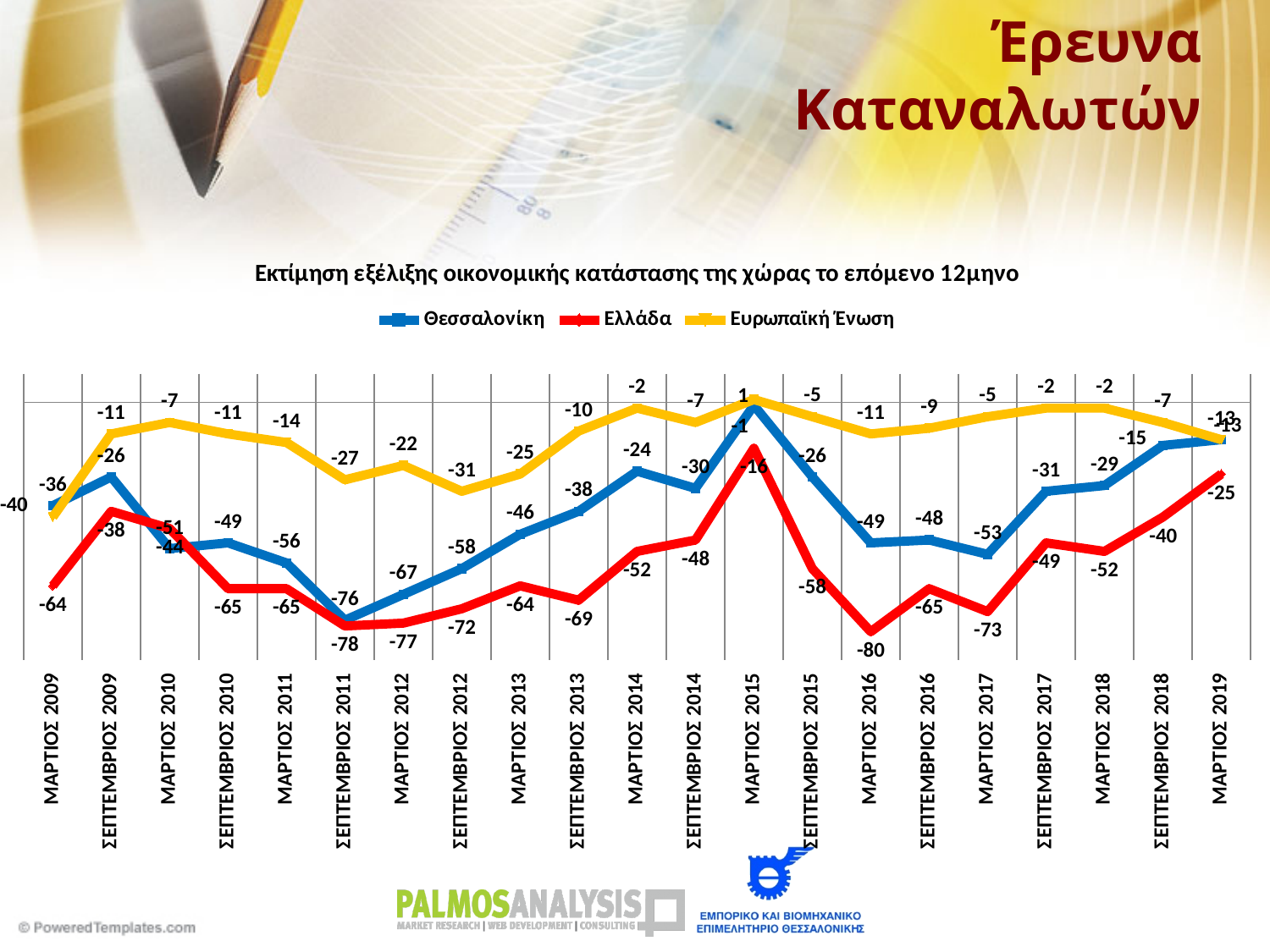
In which period does the Ελλάδα series reach its lowest value? ΜΑΡΤΙΟΣ 2016 In which period does the Θεσσαλονίκη series reach its lowest value? ΣΕΠΤΕΜΒΡΙΟΣ 2011 How many time points are plotted along the x axis? 21 What kind of chart is shown on the slide? line chart Does the Θεσσαλονίκη series rise or fall from ΣΕΠΤΕΜΒΡΙΟΣ 2011 to ΜΑΡΤΙΟΣ 2014? rise What colour is the line for Ελλάδα? red In ΜΑΡΤΙΟΣ 2012, which is higher: Θεσσαλονίκη or Ελλάδα? Θεσσαλονίκη What is the value for Θεσσαλονίκη in ΣΕΠΤΕΜΒΡΙΟΣ 2011? -76 What is the value for Ευρωπαϊκή Ένωση in ΣΕΠΤΕΜΒΡΙΟΣ 2012? -31 What is the difference between the Θεσσαλονίκη and Ελλάδα values in ΜΑΡΤΙΟΣ 2016? 31 How many series does the legend list? 3 What is the value for Ελλάδα in ΜΑΡΤΙΟΣ 2016? -80